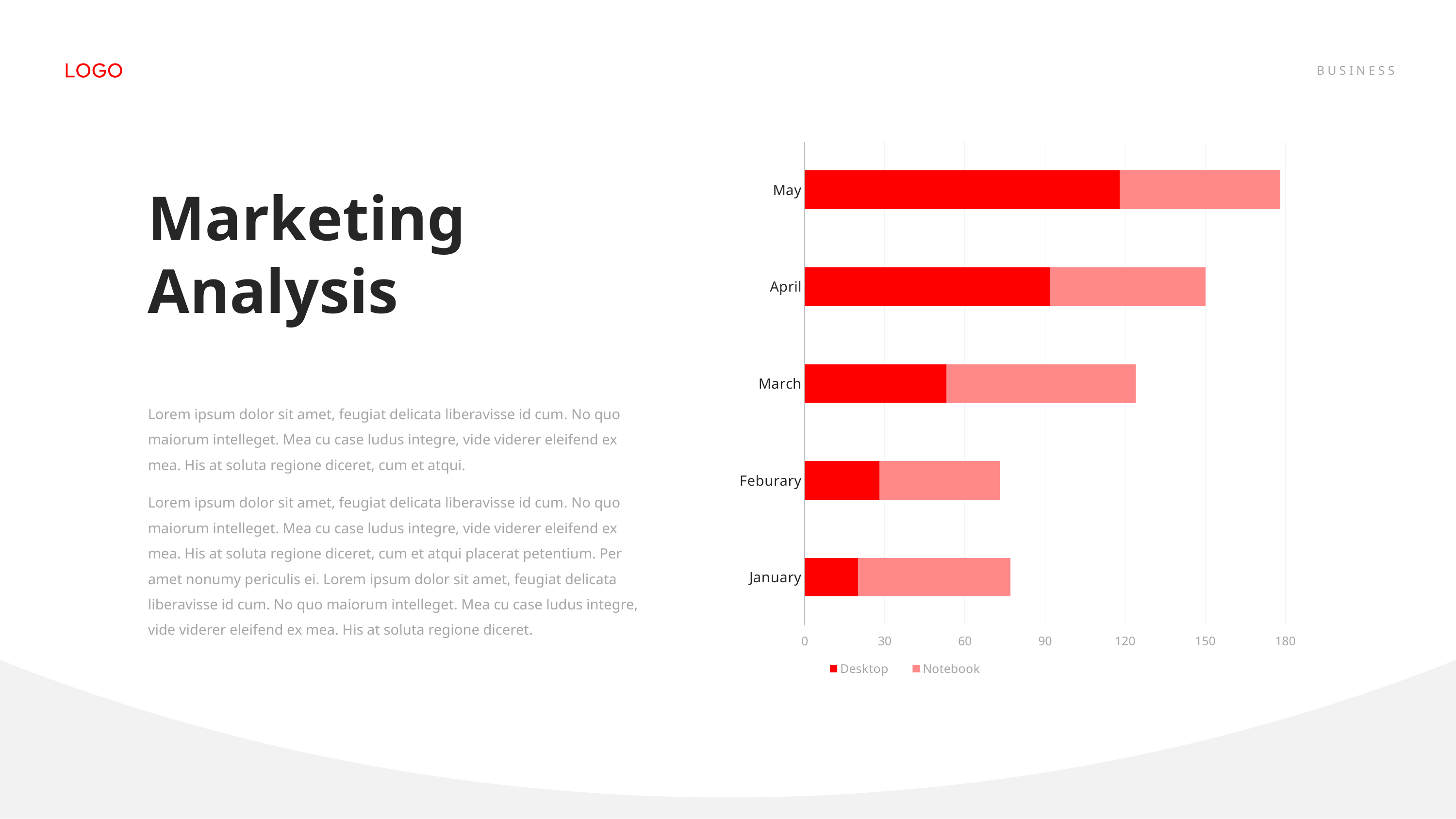
Which month has the lowest Desktop value? January Which month has the highest total bar? May Is the Desktop value for March greater or less than 60? less What kind of chart is shown on the slide? bar chart Does the Desktop value rise or fall from January to May? rise Which is larger, the total bar for April or the total bar for March? April How many series does the chart legend list? 2 Is the Desktop value for January greater or less than 30? less Which month has the highest Desktop value? May How many months are shown on the chart? 5 Is the total bar for May greater or less than 150? greater In January, which is larger, the Desktop segment or the Notebook segment? Notebook